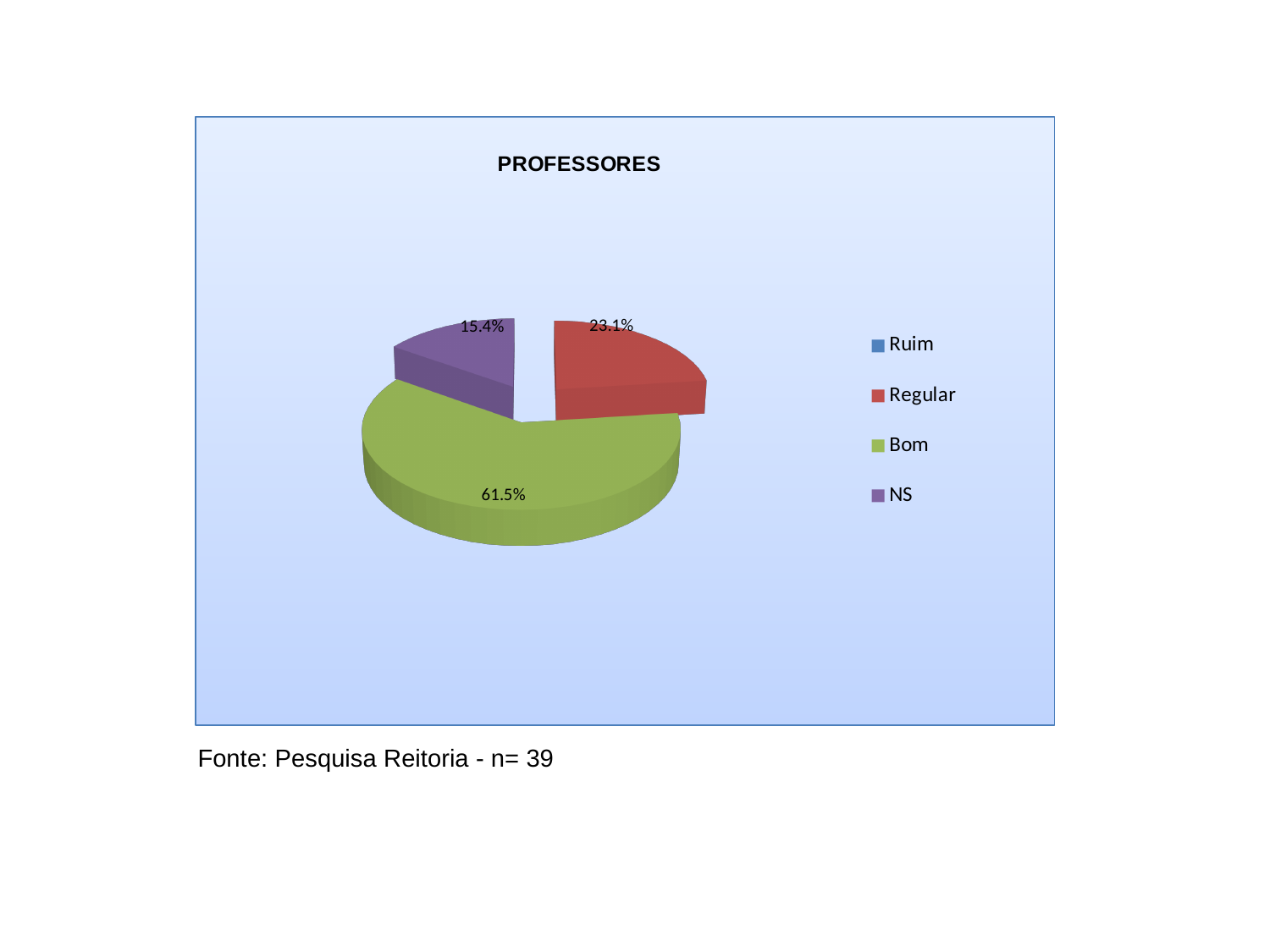
What kind of chart is shown on the slide? Pie chart What is the difference in percentage points between the Regular slice and the NS slice? 7.7% What colour is used for the Bom category in the legend? Green What is the difference in percentage points between the Bom slice and the Regular slice? 38.4% What is the title of the chart? PROFESSORES What percentage is shown for the NS slice? 15.4% What percentage of the pie does the Bom slice represent? 61.5% Of the slices with printed labels, which category has the smallest share? NS How many categories does the legend list? 4 Which category has the largest slice of the pie? Bom Which slice is larger, Regular or NS? Regular What percentage is shown for the Regular slice? 23.1%